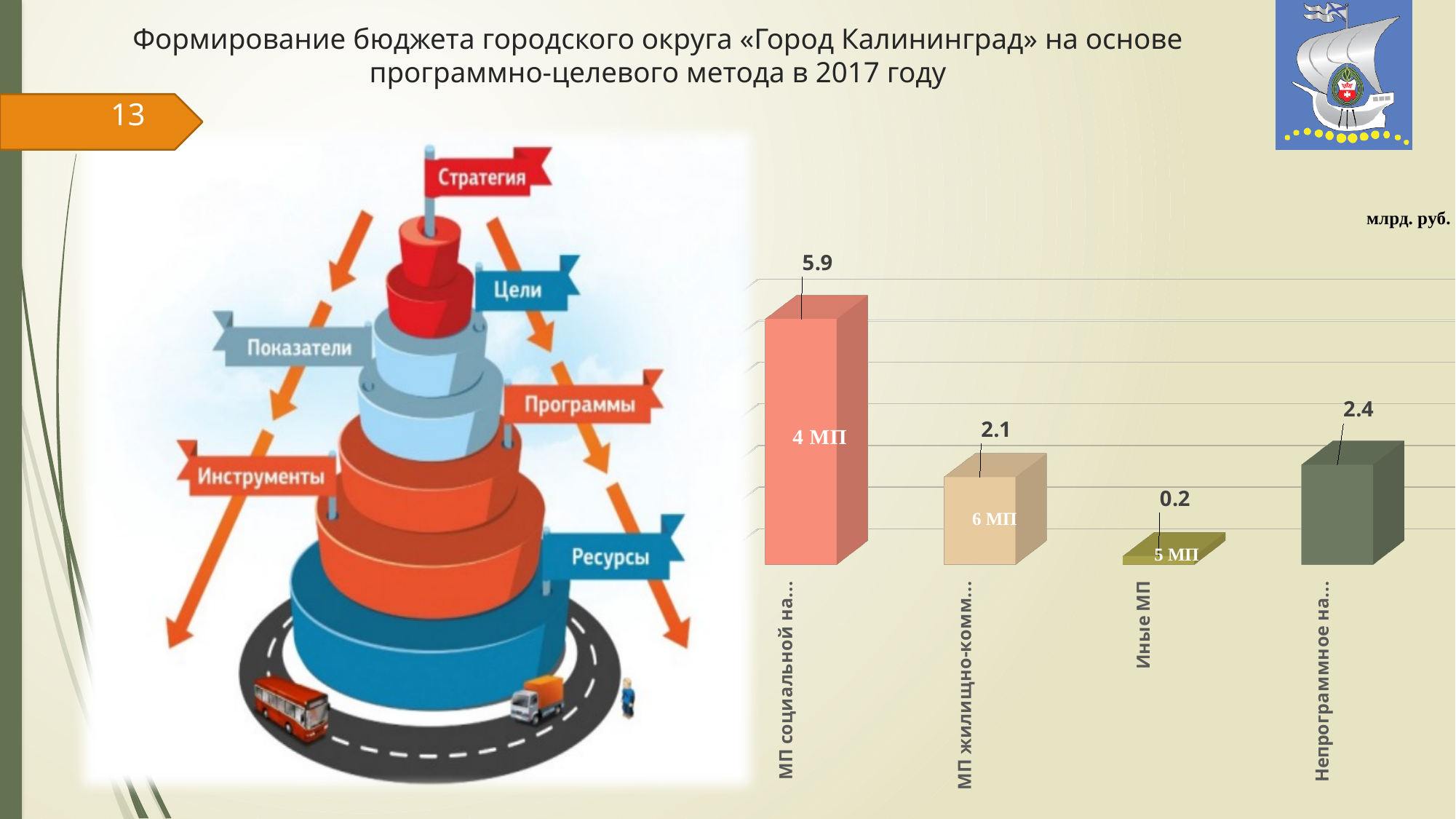
What unit is indicated for the values in the chart? млрд. руб. Which category has the lowest value? Иные МП What is the value for the category "Иные МП"? 0.2 What is the difference between the value for "МП социальной на..." and the value for "Непрограммное на..."? 3.5 Which is larger: the value for "МП жилищно-комм..." or the value for "Непрограммное на..."? Непрограммное на... What is the value of the rightmost bar, labelled "Непрограммное на..."? 2.4 What is the value of the second bar, labelled "МП жилищно-комм..."? 2.1 What text label is printed inside the bar for "МП жилищно-комм..."? 6 МП What is the value of the first (leftmost) bar, labelled "МП социальной на..."? 5.9 What kind of chart is shown on the slide? Bar chart Which category has the highest value? МП социальной на... How many categories (bars) are shown in the chart? 4